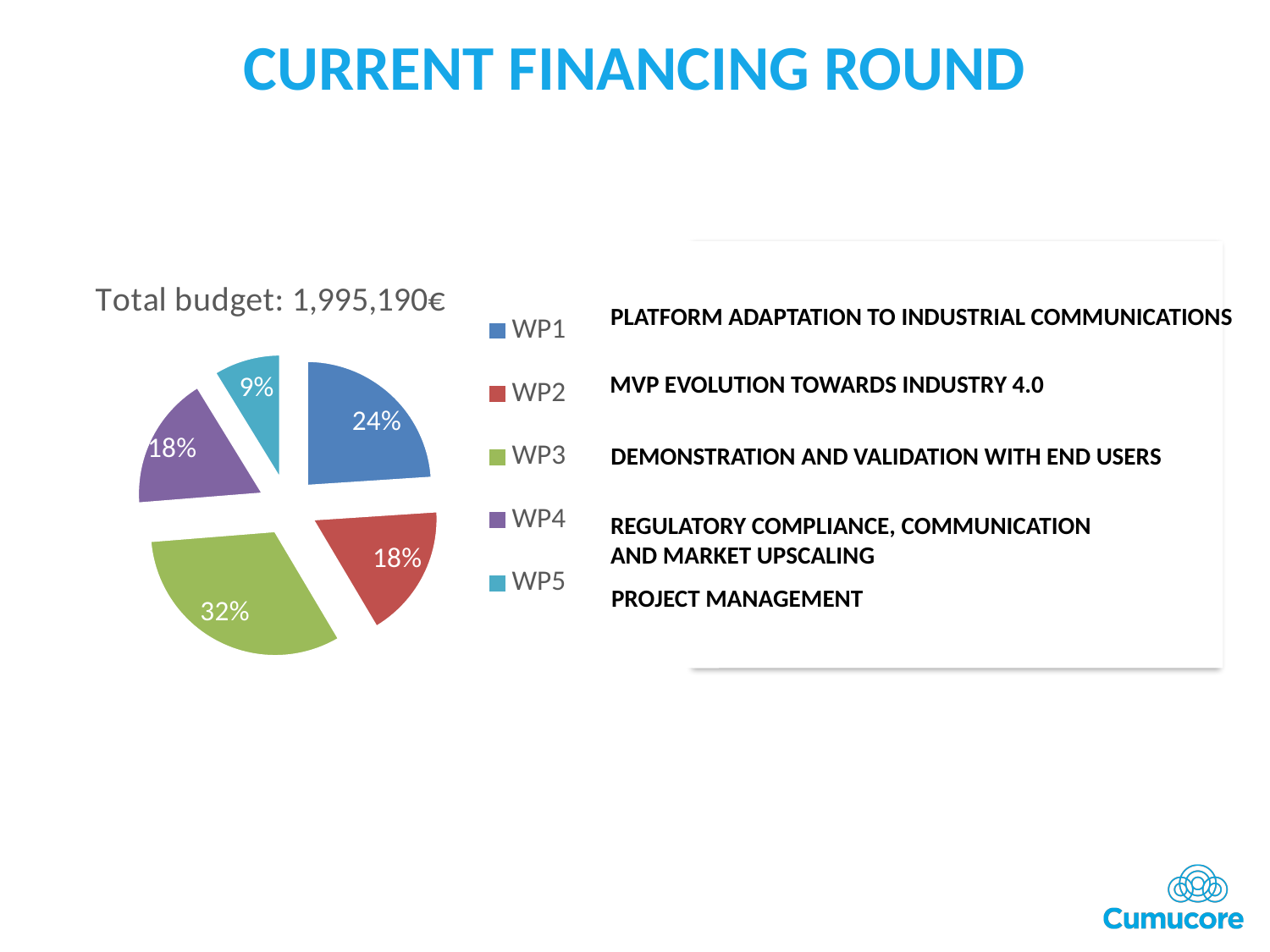
What is the total budget stated above the pie chart? 1,995,190€ Which has a larger share of the budget, WP1 or WP4? WP1 Which work package has the largest share of the budget? WP3 What share of the budget does WP2 represent? 18% What kind of chart is shown on the slide? Pie chart Which colour represents WP3 in the pie chart? Green What share of the budget does WP3 represent? 32% Which work package has the smallest share of the budget? WP5 What is the difference in percentage points between the shares of WP3 and WP1? 8 What share of the budget does WP1 represent? 24% What share of the budget does WP5 represent? 9% How many work packages are shown in the pie chart? 5